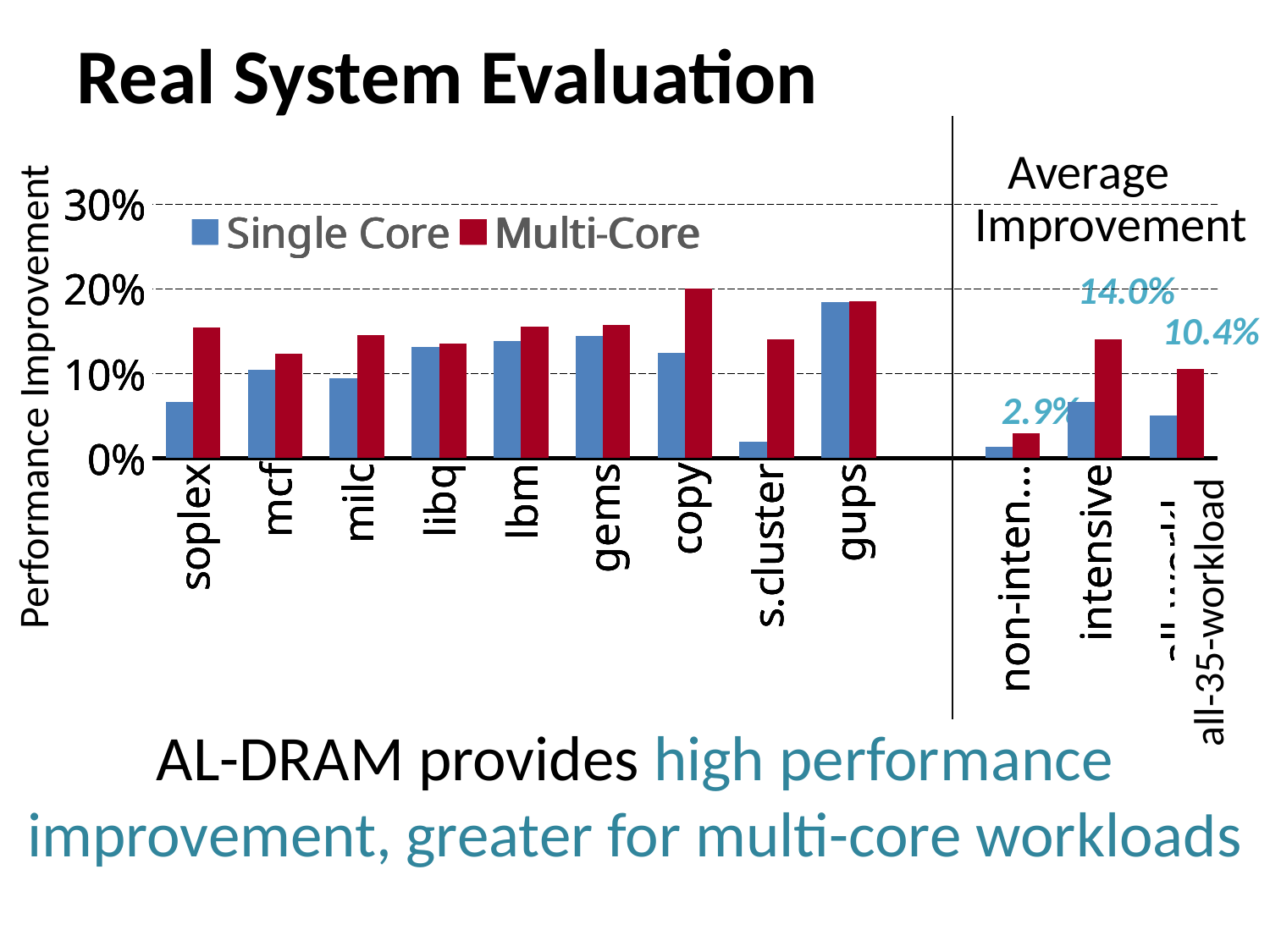
What kind of chart is shown on the slide? bar chart What is the Multi-Core average improvement for the non-intensive workloads? 2.9% What is the Multi-Core average improvement for all-35-workload? 10.4% For soplex, which is larger: the Single Core or the Multi-Core performance improvement? Multi-Core What is the label of the y axis? Performance Improvement What is the Multi-Core average improvement for the intensive workloads? 14.0% What is the difference between the Multi-Core average improvement for intensive workloads and for all-35-workload? 3.6% Is the Multi-Core performance improvement for copy greater or less than 10%? greater Among the nine individual benchmarks, which has the lowest Single Core performance improvement? s.cluster What are the two series named in the legend? Single Core and Multi-Core Among the nine individual benchmarks, which has the highest Multi-Core performance improvement? copy How many series does the legend list? 2